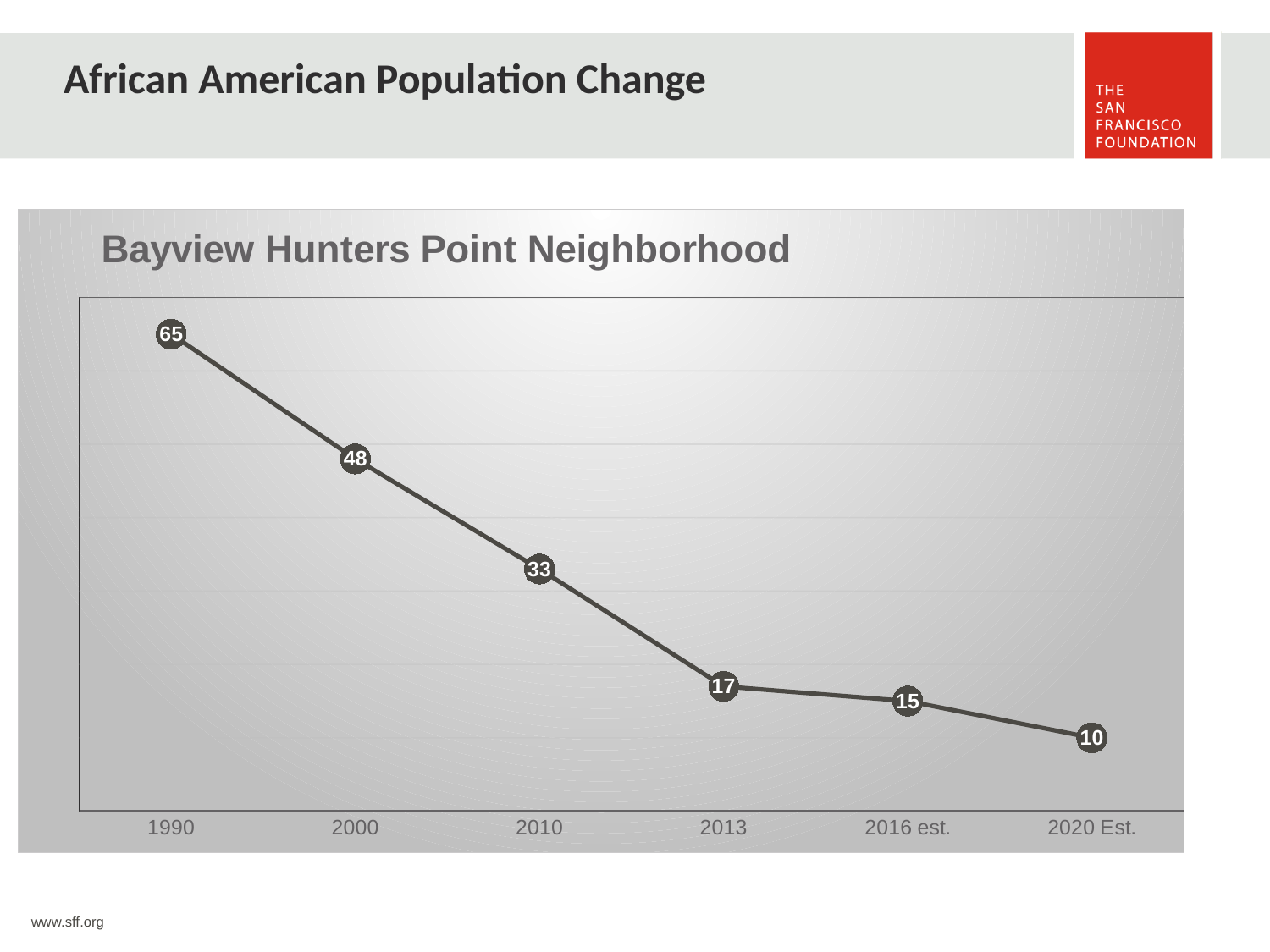
Which is larger, the value for 2000 or the value for 2010? 2000 What is the difference between the values for 2013 and 2020 Est.? 7 What is the value for 2016 est.? 15 How many data points are plotted on the chart? 6 Which year has the highest value? 1990 Which year has the lowest value? 2020 Est. What is the value for 1990? 65 Do the values rise or fall from 1990 to 2020 Est.? fall What is the value for 2010? 33 What is the difference between the values for 1990 and 2000? 17 What is the title of the chart? Bayview Hunters Point Neighborhood What kind of chart is shown? line chart